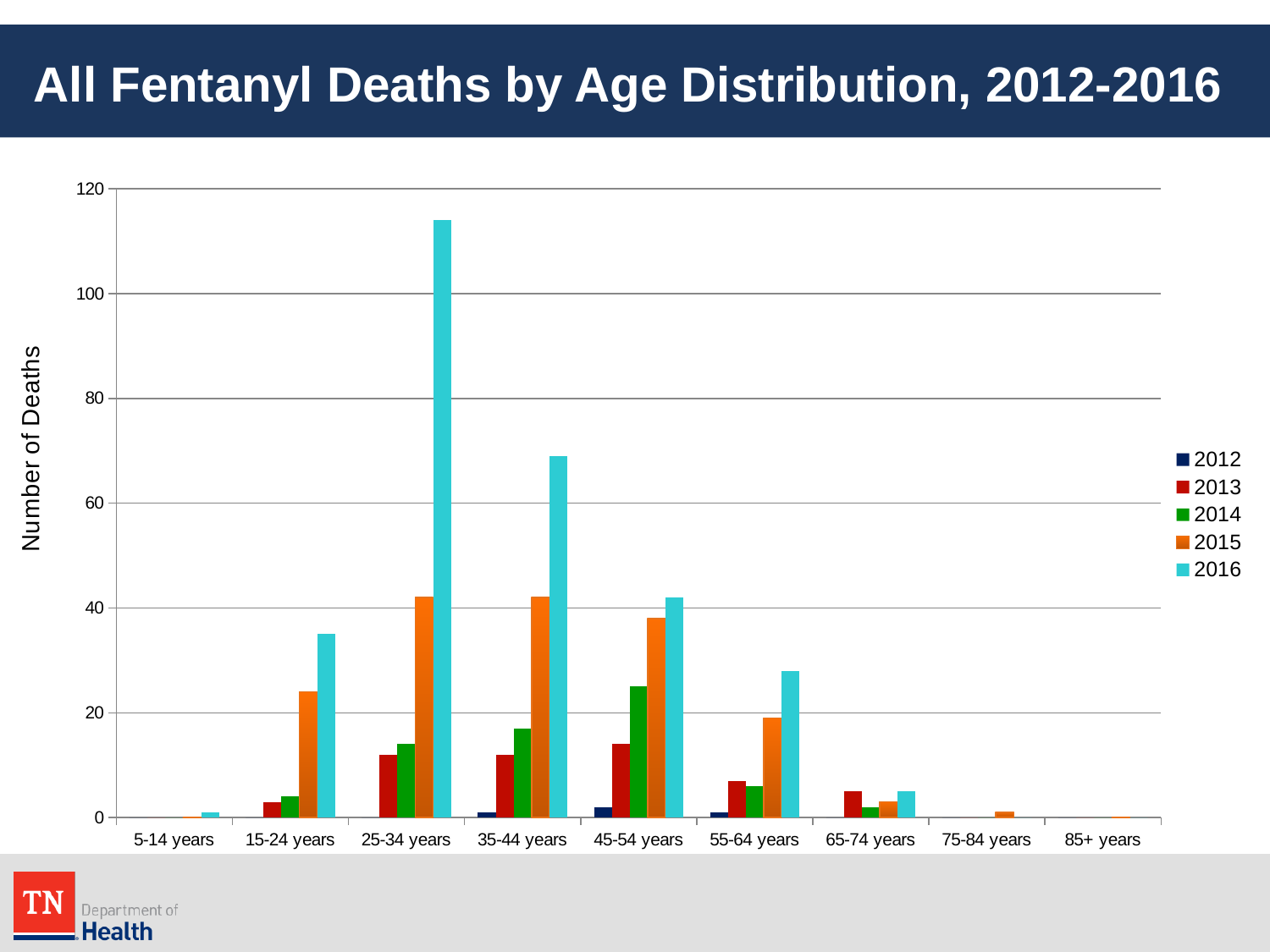
Is the value for 2016 in the 35-44 years age group greater or less than 60? greater What is the label on the y axis of the chart? Number of Deaths Is the value for 2016 in the 25-34 years age group greater or less than 100? greater What type of chart is shown on the slide? bar chart How many age groups are shown on the x axis? 9 Which is larger: the 2016 value for 35-44 years or the 2016 value for 45-54 years? 35-44 years In the 25-34 years age group, which year has the highest number of deaths? 2016 Do the 2016 values rise or fall along the x axis from 25-34 years to 85+ years? fall Which age group has the highest number of deaths for 2016? 25-34 years How many series does the legend list? 5 Is the value for 2016 in the 15-24 years age group greater or less than 40? less